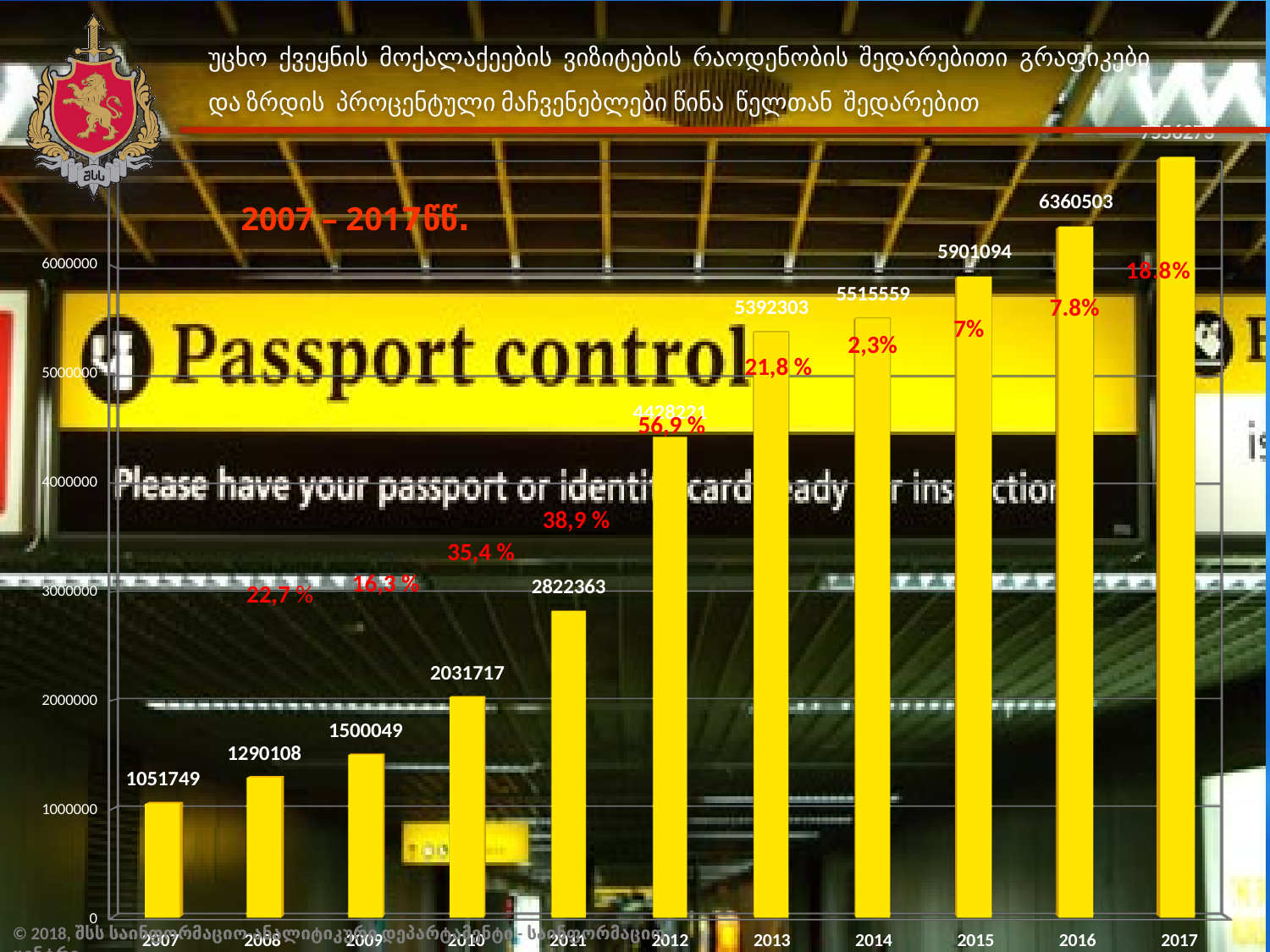
What is the value shown for 2007? 1051749 Is the value for 2017 greater or less than 6000000? greater Which year has the lowest bar? 2007 Which year has the highest bar? 2017 What is the difference between the values for 2008 and 2007? 238359 What growth percentage is shown in red for 2016? 7.8% What is the value shown for 2014? 5515559 How many years are shown on the x axis? 11 What growth percentage is shown in red for 2012? 56,9 % Which is larger, the value for 2010 or the value for 2011? 2011 What is the value shown for 2011? 2822363 What is the value shown for 2016? 6360503